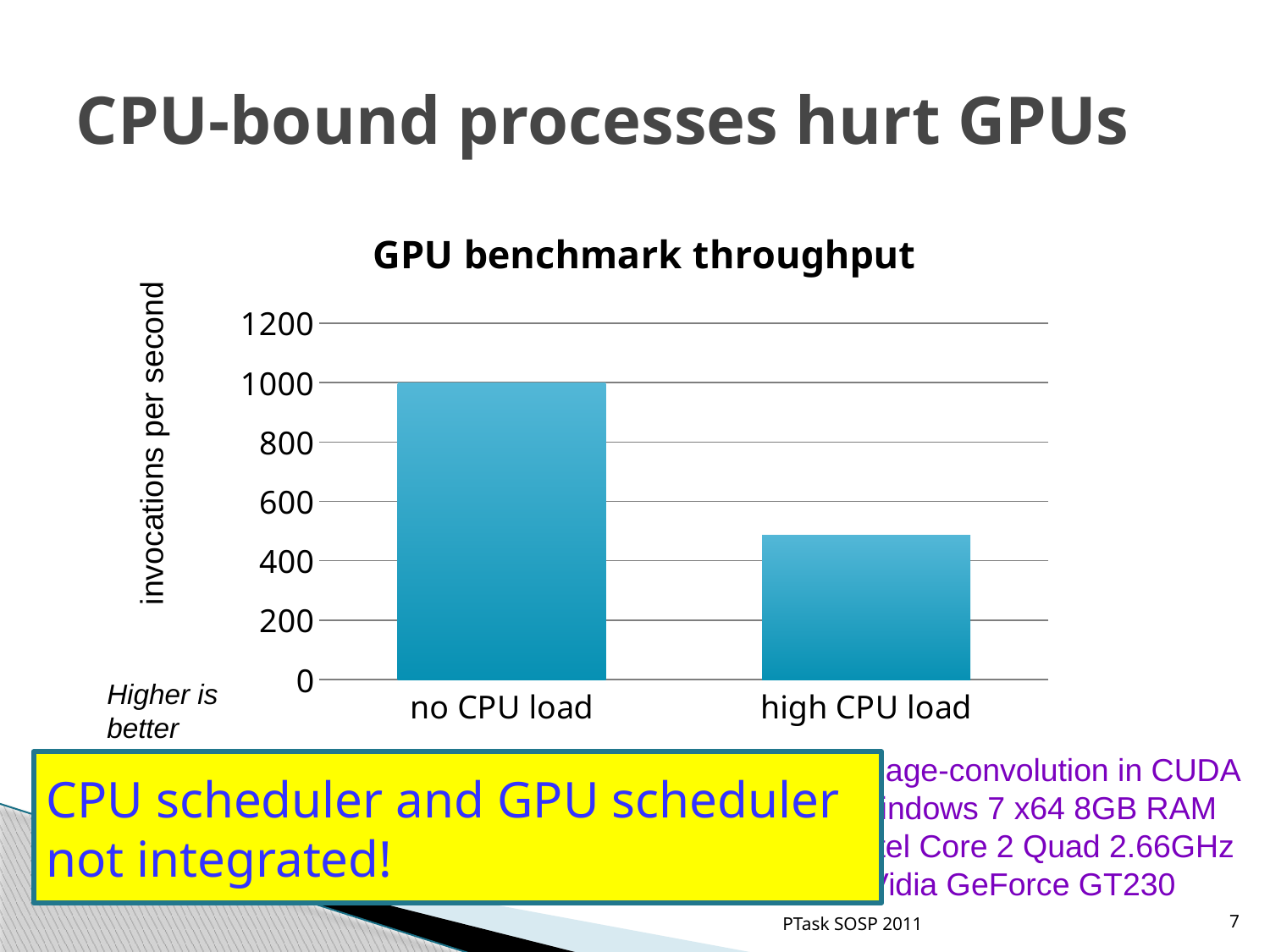
Is the value for "high CPU load" greater or less than 600? less Do the values rise or fall from "no CPU load" to "high CPU load"? fall Is the value for "no CPU load" greater or less than 800? greater What is the title of the chart? GPU benchmark throughput How many categories are plotted in the chart? 2 Which category has the highest throughput? no CPU load Which is larger, the value for "no CPU load" or the value for "high CPU load"? no CPU load Is the value for "high CPU load" greater or less than 400? greater What is the label on the vertical axis of the chart? invocations per second What kind of chart is shown on the slide? bar chart Which category has the lowest throughput? high CPU load